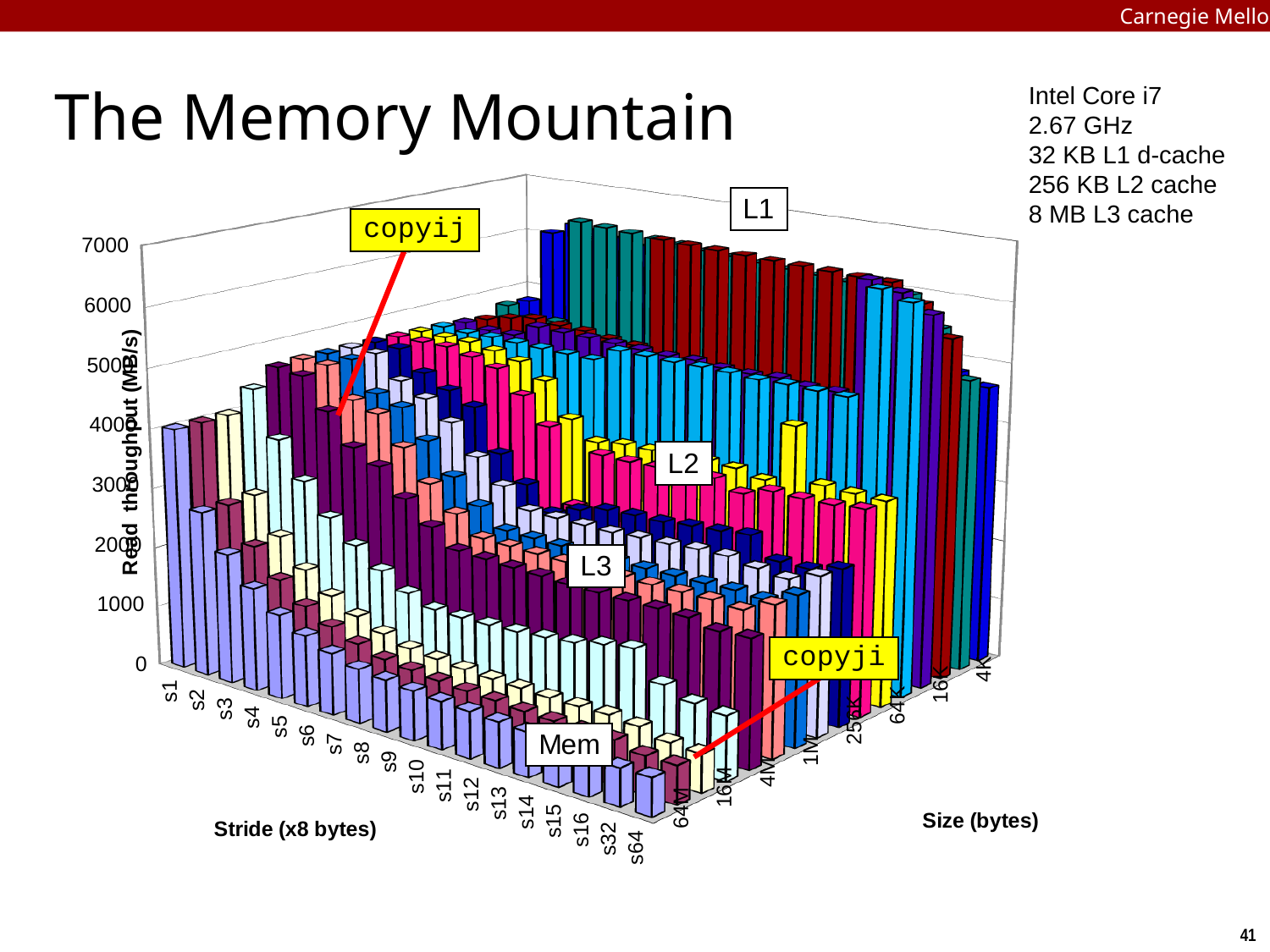
For the 64M size, do the read throughput values rise or fall as the stride increases from s1 to s64? fall Which is larger: the read throughput for stride s1 at size 64M or for stride s64 at size 64M? s1 at 64M What is the title of the vertical axis? Read throughput (MB/s) How many stride categories are labeled along the Stride (x8 bytes) axis? 18 What is the last size label on the Size (bytes) axis? 4K Is the read throughput for stride s1 at size 64M greater or less than 1000? greater What kind of chart is shown on the slide? 3D bar chart Is the read throughput for stride s64 at size 64M greater or less than 1000? less How many size categories are labeled along the Size (bytes) axis? 8 What is the first stride label on the Stride (x8 bytes) axis? s1 What is the highest tick value shown on the vertical axis? 7000